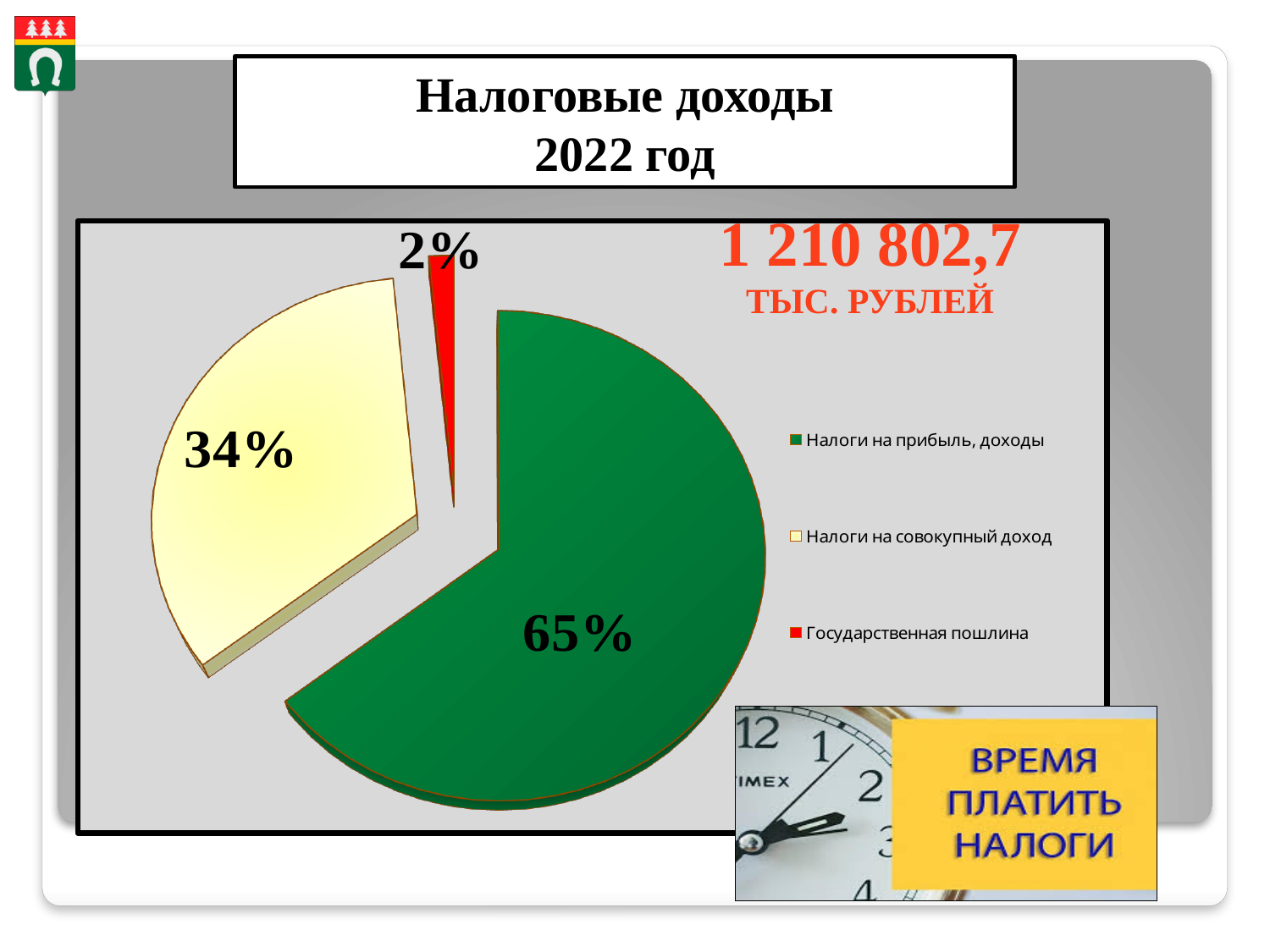
What share of the pie does "Налоги на прибыль, доходы" take? 65% Which category has the largest slice of the pie? Налоги на прибыль, доходы What share of the pie does "Государственная пошлина" take? 2% How many entries does the legend list? 3 How many categories does the pie chart show? 3 What total amount in thousand rubles is printed next to the pie chart? 1 210 802,7 What share of the pie does "Налоги на совокупный доход" take? 34% What is the title of the slide? Налоговые доходы 2022 год What kind of chart is shown on the slide? pie chart What is the difference in percentage points between "Налоги на прибыль, доходы" and "Налоги на совокупный доход"? 31 Which category has the smallest slice of the pie? Государственная пошлина Which is larger: the share for "Налоги на совокупный доход" or the share for "Государственная пошлина"? Налоги на совокупный доход